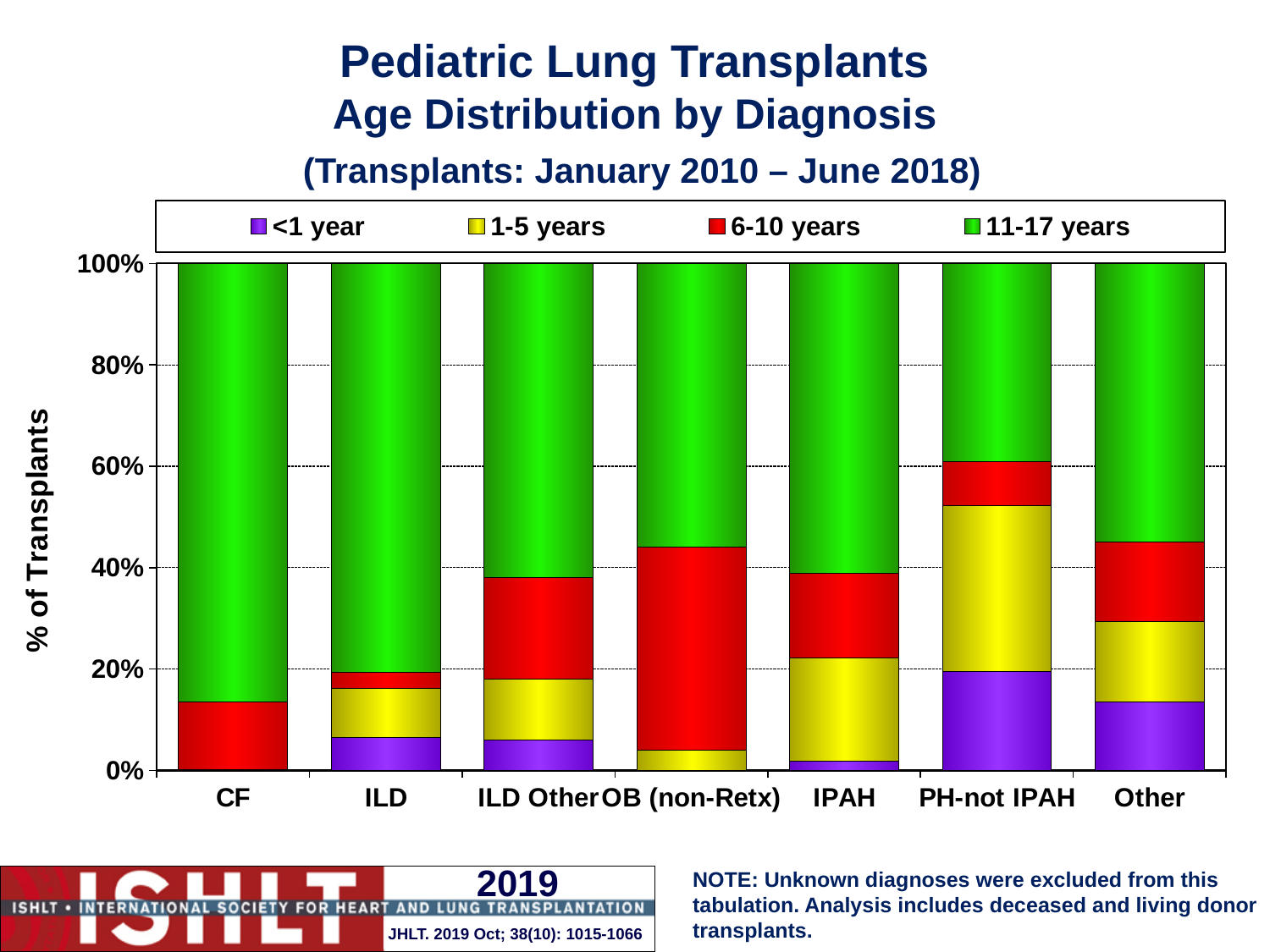
Is the 1-5 years share for PH-not IPAH greater or less than 20%? greater Which has a larger <1 year share: PH-not IPAH or ILD? PH-not IPAH What kind of chart is shown on the slide? stacked bar chart Is the 6-10 years share for OB (non-Retx) greater or less than 20%? greater Which diagnosis category has the largest share of transplants in the 6-10 years age group? OB (non-Retx) Which has a larger 11-17 years share: CF or OB (non-Retx)? CF Is the 11-17 years share for CF greater or less than 80%? greater How many age-group series does the legend list? 4 Which diagnosis category has the largest share of transplants in the <1 year age group? PH-not IPAH What colour represents the 11-17 years age group in the chart? green Which diagnosis category has the largest share of transplants in the 11-17 years age group? CF How many diagnosis categories are shown on the x axis? 7